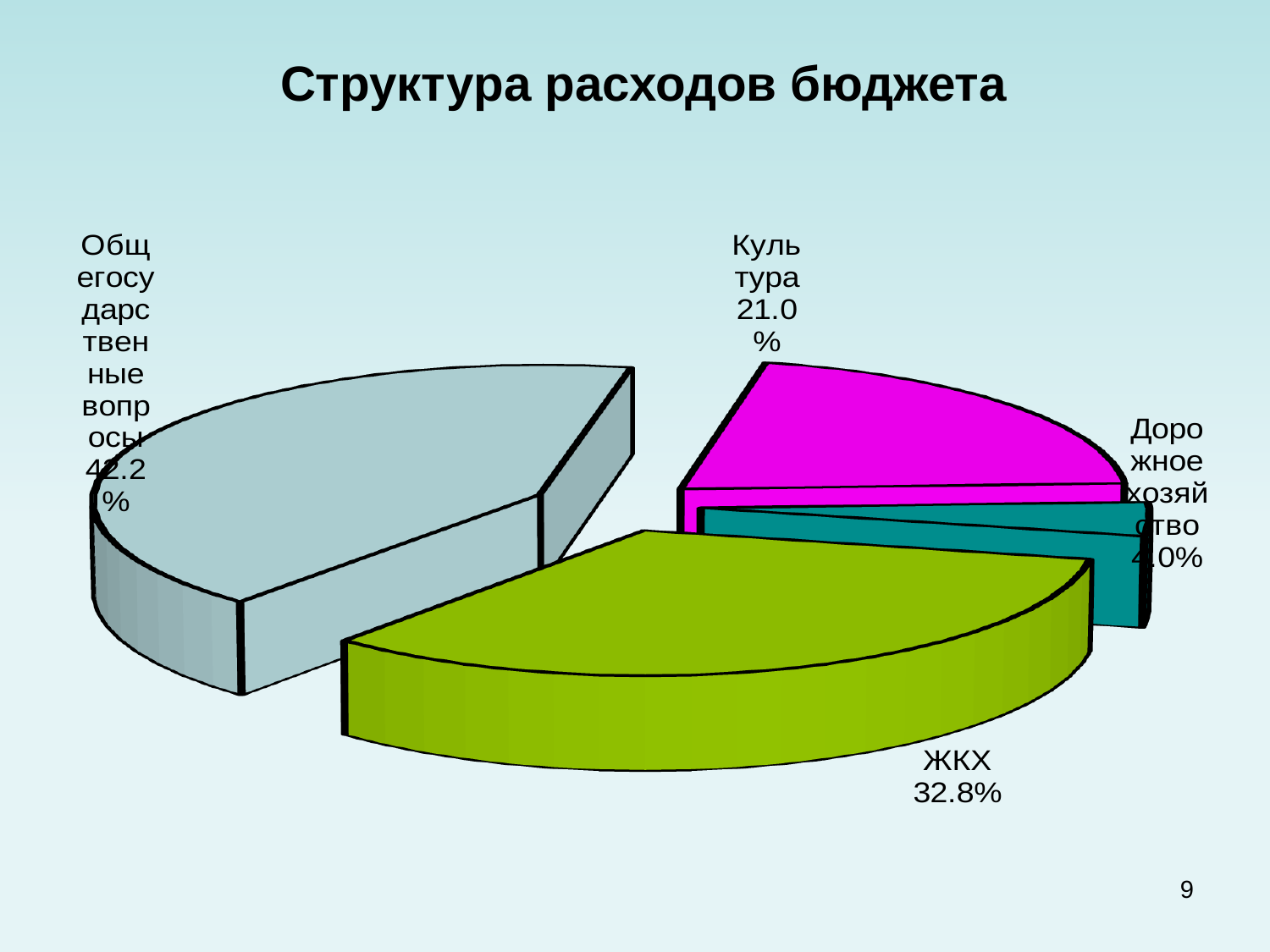
What colour is the slice for Культура? magenta What share of the budget expenditure goes to Дорожное хозяйство? 4.0% Which is larger, the share for ЖКХ or the share for Культура? ЖКХ What share of the budget expenditure goes to Общегосударственные вопросы? 42.2% What is the title of the chart? Структура расходов бюджета Which category has the largest share of budget expenditure? Общегосударственные вопросы How many slices does the pie chart have? 4 Which category has the smallest share of budget expenditure? Дорожное хозяйство What share of the budget expenditure goes to ЖКХ? 32.8% What is the difference in percentage points between the ЖКХ share and the Культура share? 11.8 What kind of chart is shown on the slide? pie chart What share of the budget expenditure goes to Культура? 21.0%